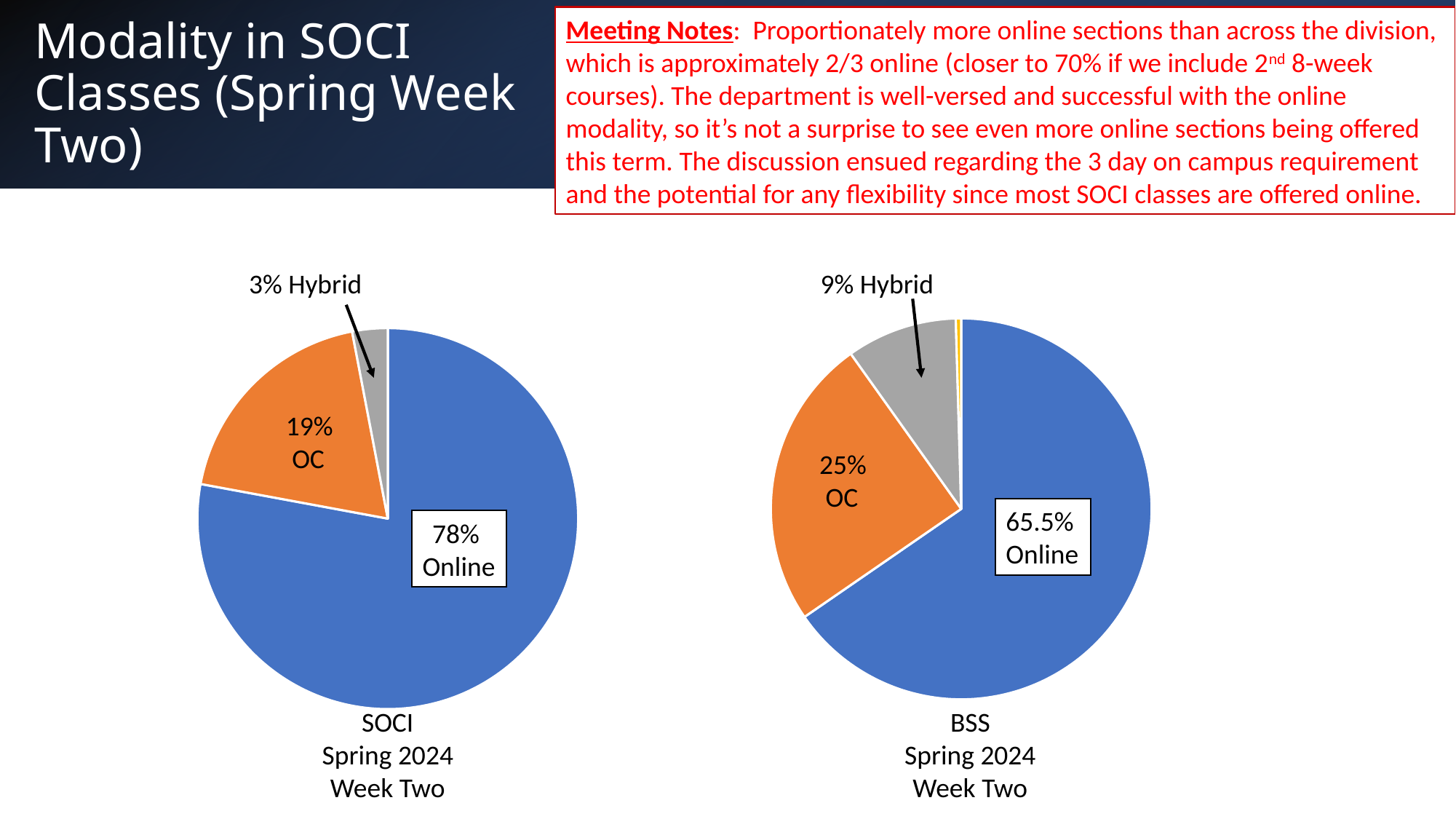
In the BSS Spring 2024 Week Two pie chart, which modality has the largest share? Online In the SOCI Spring 2024 Week Two pie chart, what is the difference in percentage points between the OC share and the Hybrid share? 16 Which chart shows a larger Online share, SOCI Spring 2024 Week Two or BSS Spring 2024 Week Two? SOCI Spring 2024 Week Two How many slices does the SOCI Spring 2024 Week Two pie chart have? 3 In the BSS Spring 2024 Week Two pie chart, what percentage is labelled Hybrid? 9% What is the difference in percentage points between the Online share in the SOCI chart (78%) and the Online share in the BSS chart (65.5%)? 12.5 In the SOCI Spring 2024 Week Two pie chart, which modality has the largest share? Online In the SOCI Spring 2024 Week Two pie chart, what percentage is labelled OC? 19% In the SOCI Spring 2024 Week Two pie chart, what percentage of classes are Online? 78% What kind of chart is used on this slide to show modality? Pie chart In the SOCI Spring 2024 Week Two pie chart, which labelled modality has the smallest share? Hybrid In the BSS Spring 2024 Week Two pie chart, what percentage of classes are Online? 65.5%